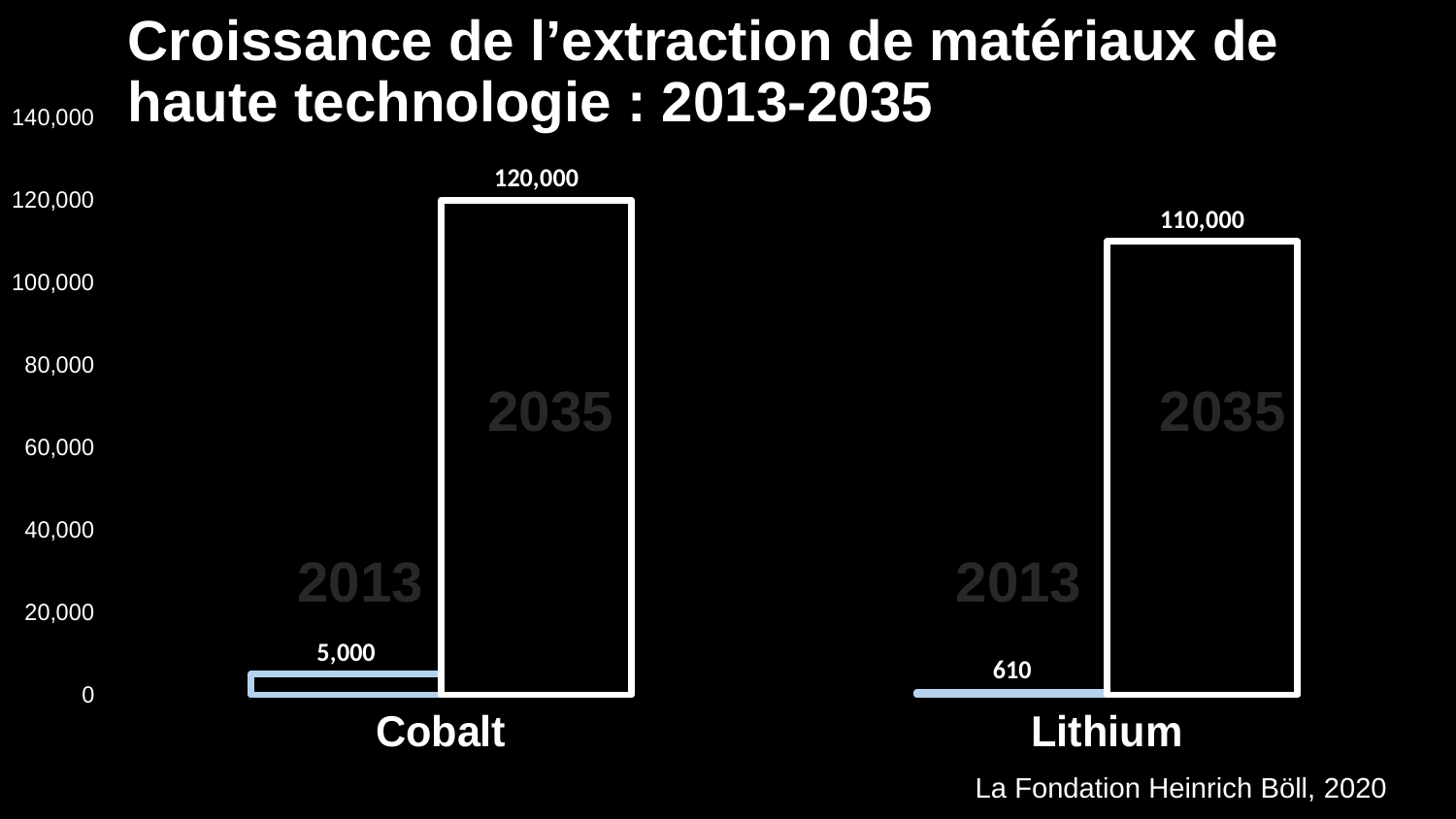
Which is larger: the 2013 value for Cobalt or the 2013 value for Lithium? Cobalt What is the difference between the 2035 values for Cobalt and Lithium? 10,000 What is the title of the chart? Croissance de l’extraction de matériaux de haute technologie : 2013-2035 What is the value for Cobalt in 2035? 120,000 Which category has the lowest 2013 value? Lithium What kind of chart is shown on the slide? Bar chart What is the value for Lithium in 2013? 610 How many categories are shown on the x axis? 2 Which category has the highest 2035 value? Cobalt What is the difference between the 2035 and 2013 values for Cobalt? 115,000 What is the value for Lithium in 2035? 110,000 What is the value for Cobalt in 2013? 5,000